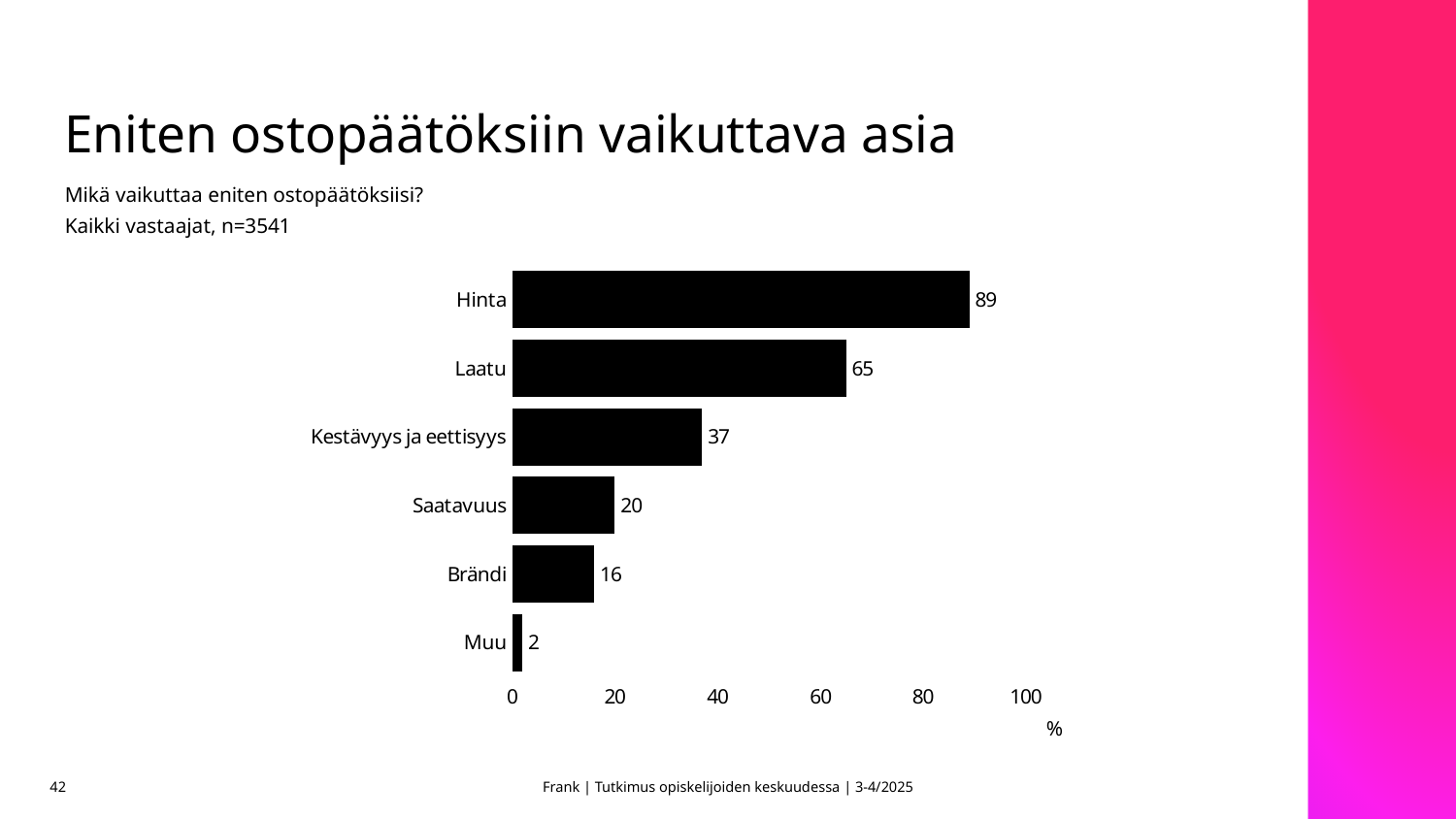
Which is larger, the value for Laatu or the value for Kestävyys ja eettisyys? Laatu What is the difference between the values for Hinta and Laatu? 24 What is the value for Hinta? 89 What unit is shown on the x axis of the chart? % What is the value for Brändi? 16 Is the value for Kestävyys ja eettisyys greater or less than 40? less How many categories are shown in the chart? 6 What is the value for Kestävyys ja eettisyys? 37 Which category has the lowest value? Muu Which category has the highest value? Hinta What kind of chart is shown on the slide? bar chart What is the difference between the values for Saatavuus and Brändi? 4